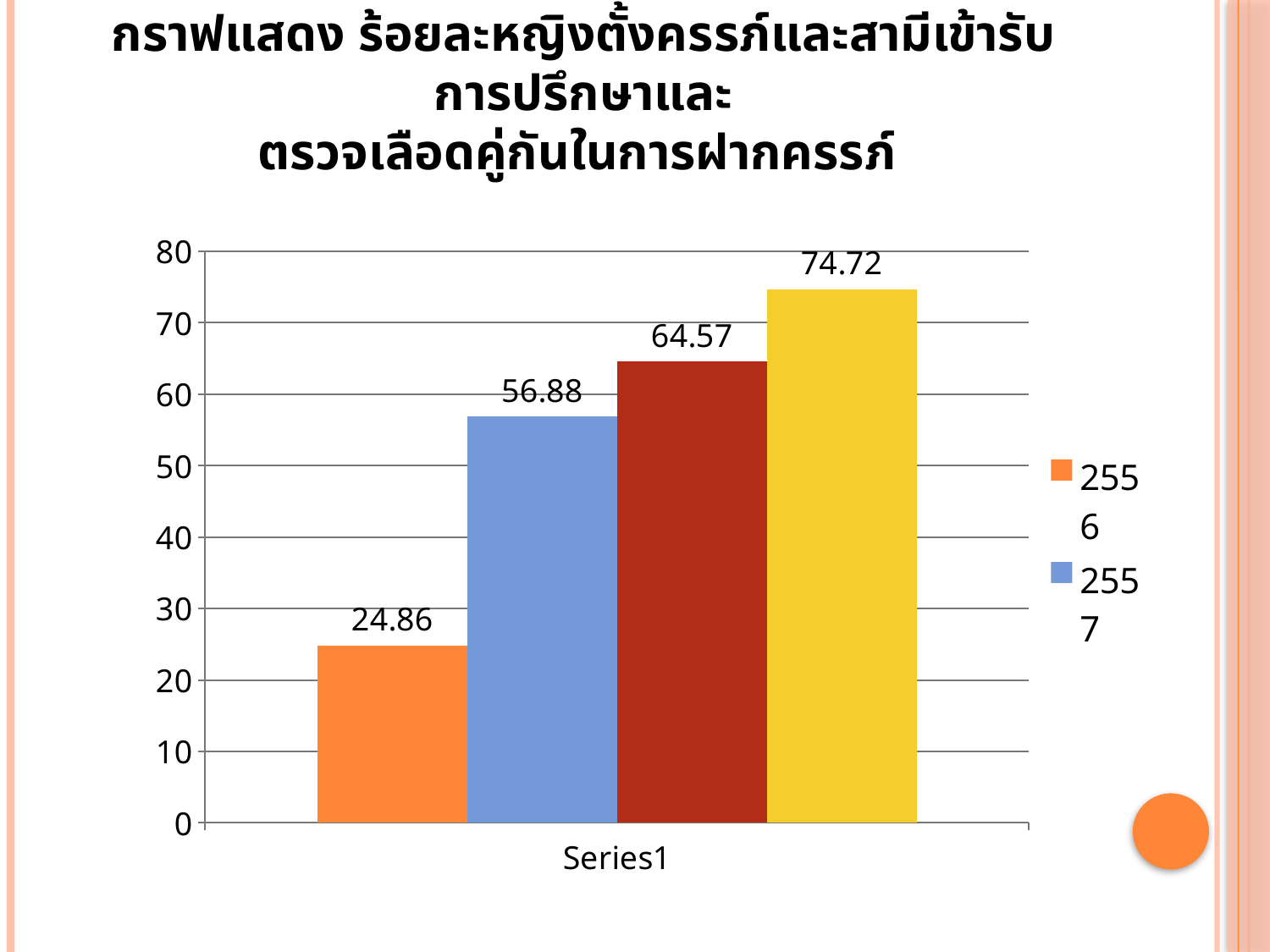
What is the highest value shown on the chart? 74.72 What is the value for 2557? 56.88 Which is larger, the value for 2556 or the value for 2557? 2557 Do the bar values rise or fall from left to right? rise What kind of chart is shown on the slide? bar chart Is the value for 2556 greater or less than 30? less What is the difference between the values for 2557 and 2556? 32.02 What is the category label shown on the x axis? Series1 What is the lowest value shown on the chart? 24.86 What is the value for 2556? 24.86 Is the value for 2557 greater or less than 50? greater How many bars are plotted on the chart? 4